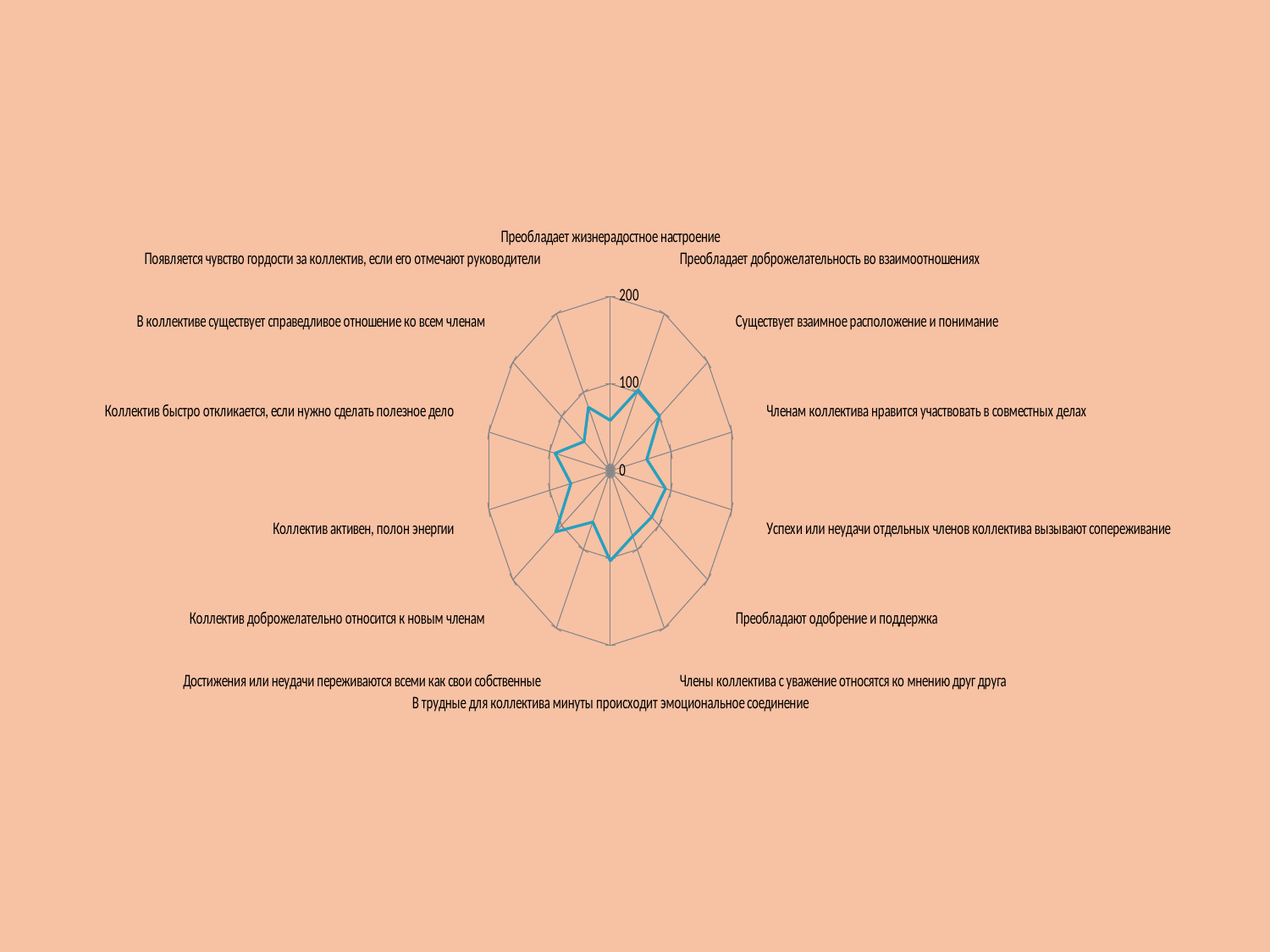
Is the value for "Преобладает жизнерадостное настроение" greater or less than 100? less What kind of chart is shown on the slide? radar chart Which category is plotted at the top of the radar chart? Преобладает жизнерадостное настроение What tick values are labelled on the radar chart's axis? 0, 100, 200 How many categories (axes) does the radar chart have? 14 Is the value for "Преобладает доброжелательность во взаимоотношениях" greater or less than 200? less What is the highest value labelled on the radar chart's axis? 200 Is the value for "В трудные для коллектива минуты происходит эмоциональное соединение" greater or less than 200? less